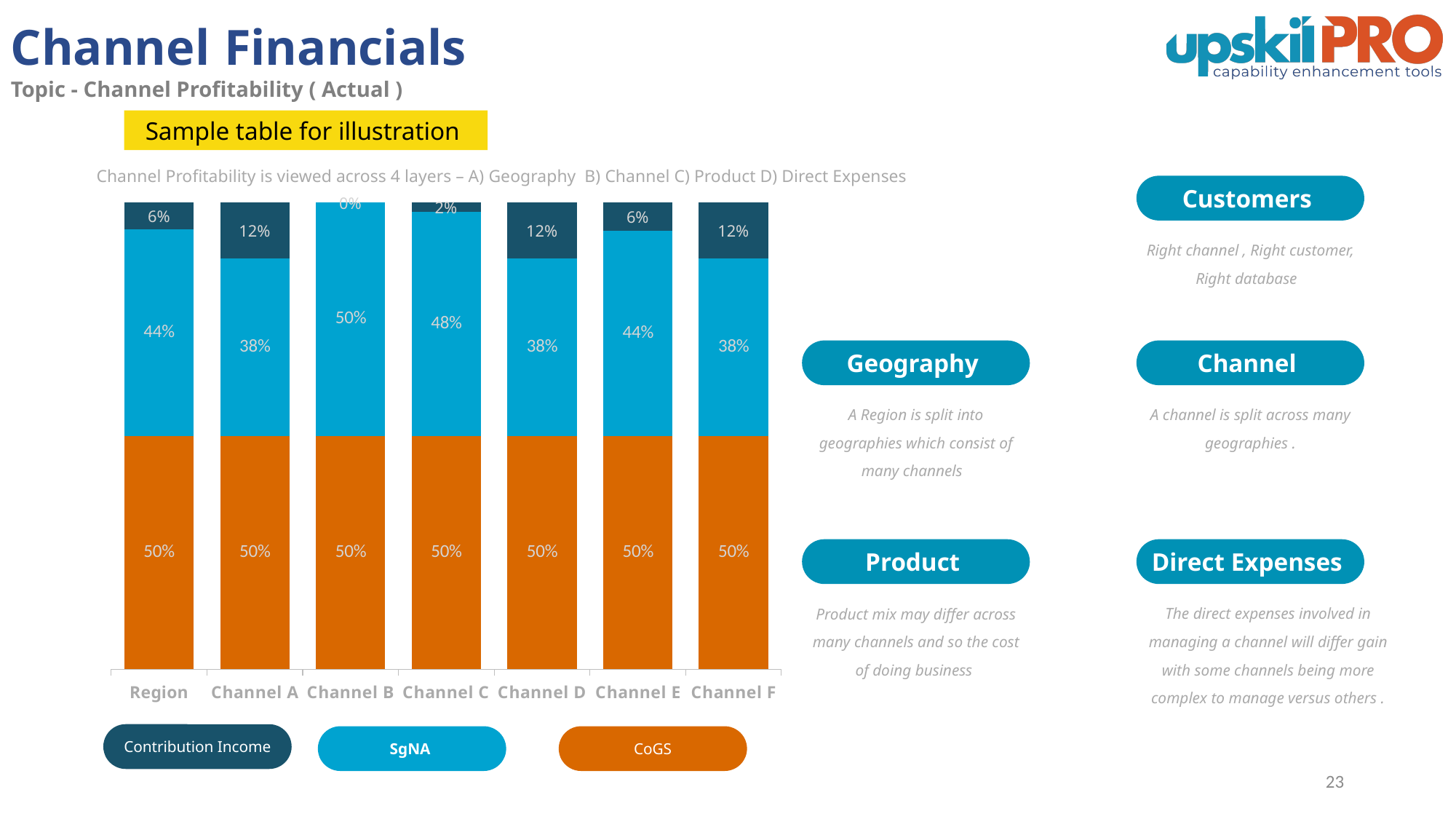
What is the difference between the SgNA values for Region and Channel A? 6% What is the CoGS value for Region? 50% What is the SgNA value for Channel B? 50% How many categories are shown along the x axis of the chart? 7 What is the Contribution Income value for Channel C? 2% How many series does the legend below the chart list? 3 What kind of chart is shown on the slide? Stacked bar chart Which is larger, the Contribution Income value for Channel D or for Channel E? Channel D What is the Contribution Income value for Channel A? 12% Which category has the highest SgNA value? Channel B Which category has the lowest Contribution Income value? Channel B Which series is shown in orange in the chart? CoGS